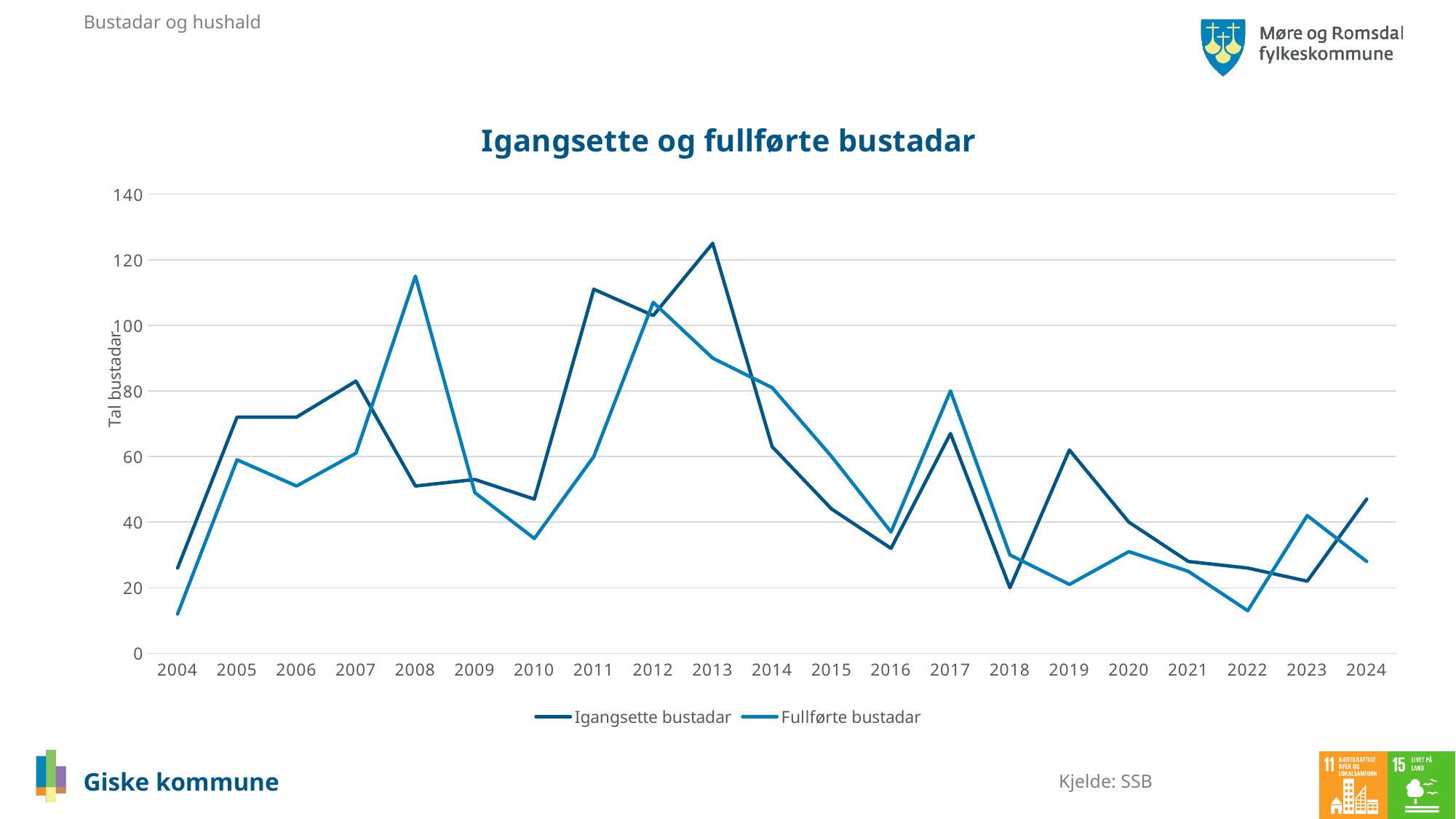
What is the title of the chart? Igangsette og fullførte bustadar Is the value for Igangsette bustadar in 2018 greater or less than 40? less In which year does the Igangsette bustadar series reach its highest value? 2013 What kind of chart is shown on the slide? Line chart How many series does the legend list? 2 Is the value for Igangsette bustadar in 2013 greater or less than 120? greater In 2019, which series has the larger value, Igangsette bustadar or Fullførte bustadar? Igangsette bustadar Is the value for Fullførte bustadar in 2008 greater or less than 100? greater Does the Igangsette bustadar series rise or fall from 2013 to 2018? Fall In which year does the Fullførte bustadar series reach its highest value? 2008 How many years are plotted along the x axis? 21 In which year is the Fullførte bustadar series at its lowest? 2004